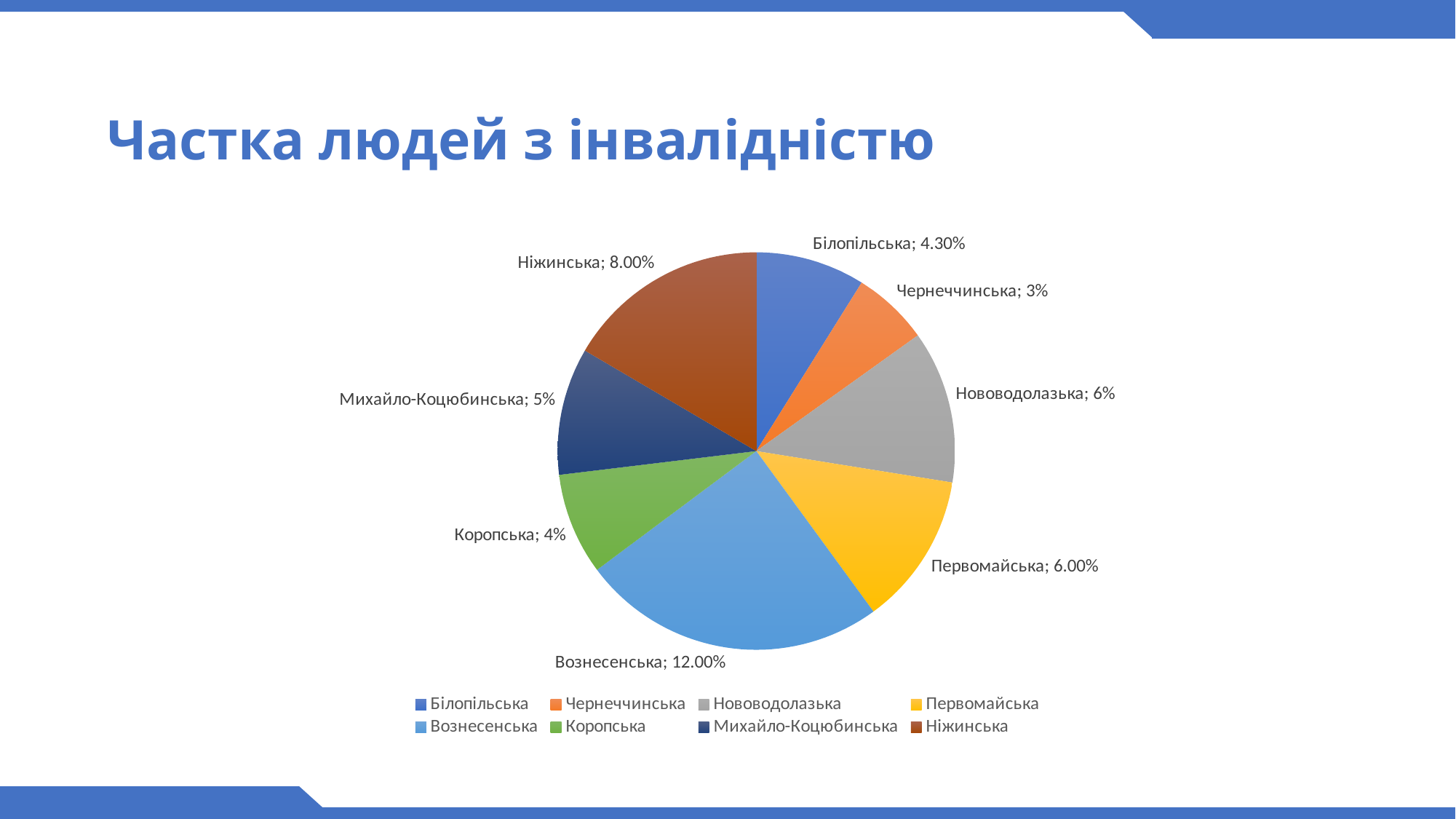
What is the difference between the values for Вознесенська and Ніжинська? 4.00% What value is shown for Ніжинська? 8.00% What kind of chart is shown on the slide? pie chart Which category has the smallest slice of the pie? Чернеччинська Which is larger, the value for Ніжинська or the value for Коропська? Ніжинська What is the difference between the values for Нововодолазька and Чернеччинська? 3% What value is shown for Михайло-Коцюбинська? 5% What value is shown for Білопільська? 4.30% How many categories are shown in the pie chart? 8 What is the title of the chart? Частка людей з інвалідністю Which category has the largest slice of the pie? Вознесенська What value is shown for Вознесенська? 12.00%